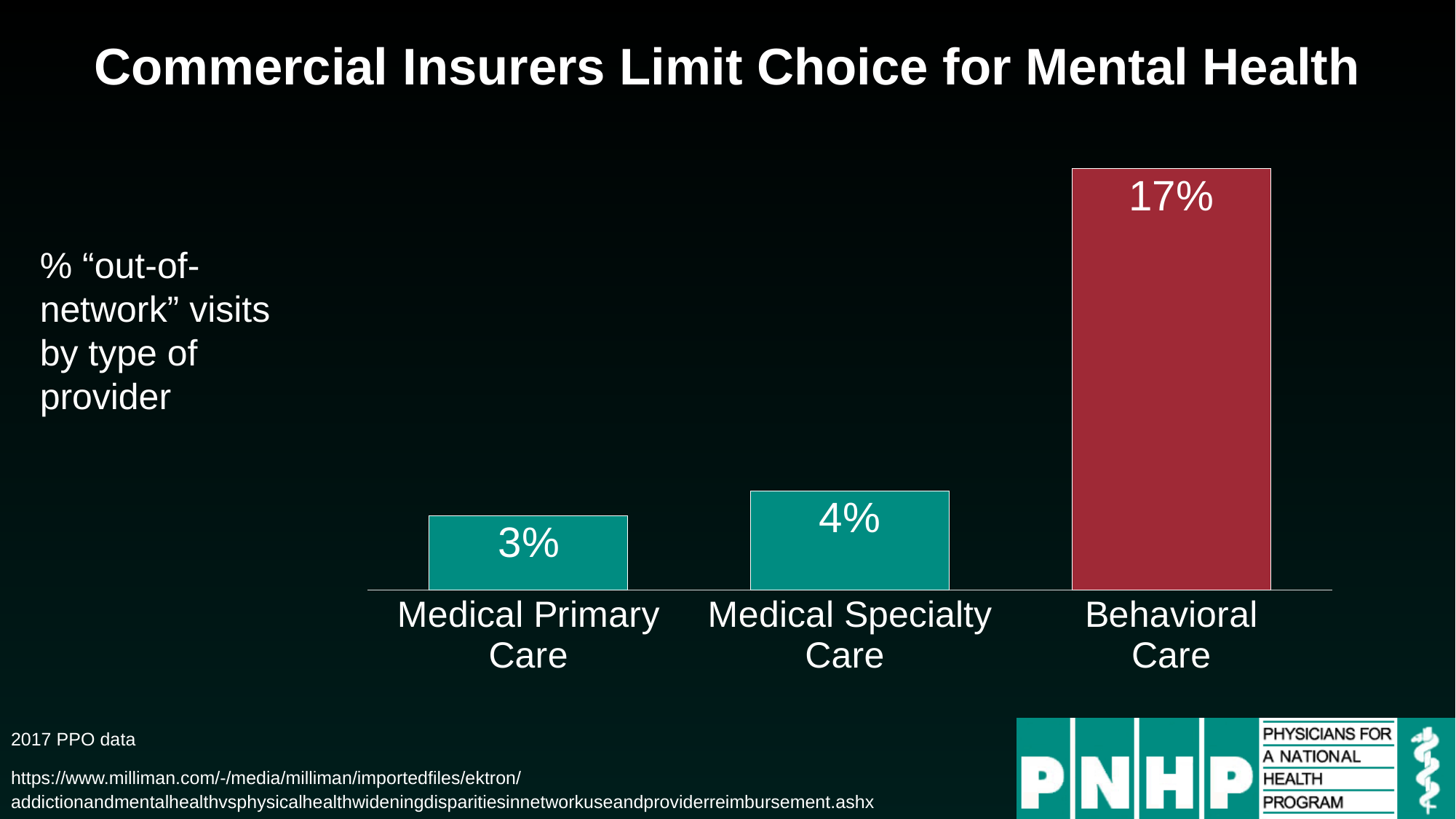
What is the difference in percentage points between Behavioral Care and Medical Specialty Care? 13 What kind of chart is shown on the slide? Bar chart What is the percentage of out-of-network visits for Medical Specialty Care? 4% Do the values rise or fall moving from left to right across the categories? Rise What is the percentage of out-of-network visits for Medical Primary Care? 3% How many types of provider are shown in the chart? 3 Which type of provider has the lowest percentage of out-of-network visits? Medical Primary Care Which bar is shown in a different colour (red) from the others? Behavioral Care What is the percentage of out-of-network visits for Behavioral Care? 17% Which type of provider has the highest percentage of out-of-network visits? Behavioral Care Which has a higher percentage of out-of-network visits, Medical Specialty Care or Behavioral Care? Behavioral Care What is the difference in percentage points between Medical Specialty Care and Medical Primary Care? 1